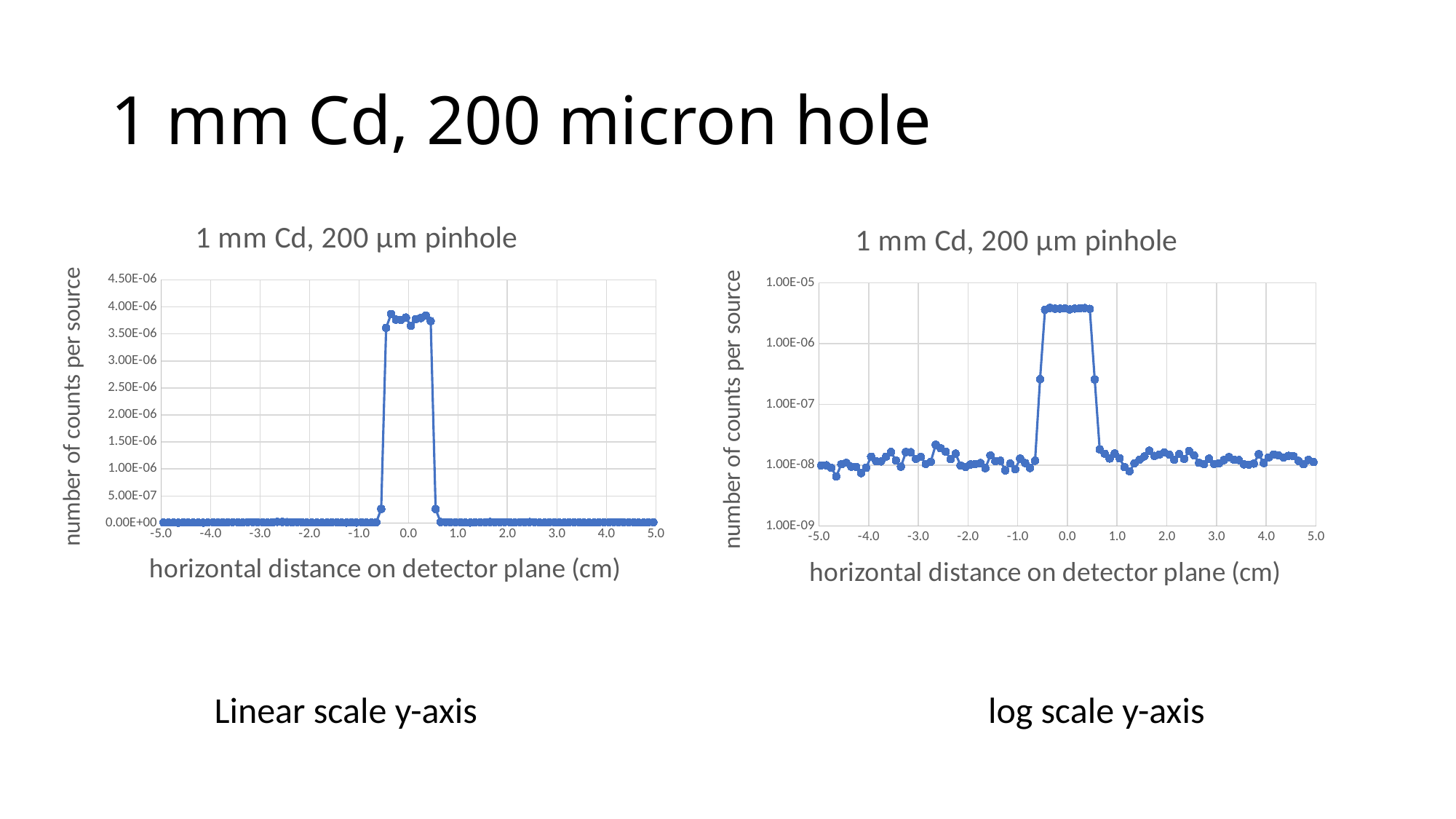
In the left chart (linear scale y-axis), is the value at a horizontal distance of 0.0 cm greater or less than 3.00E-06? greater In the left chart (linear scale y-axis), is the value at a horizontal distance of 3.0 cm greater or less than 5.00E-07? less In the right chart (log scale y-axis), is the value at a horizontal distance of 0.0 cm greater or less than 1.00E-06? greater What is the x-axis label of the left chart (linear scale y-axis)? horizontal distance on detector plane (cm) In the right chart (log scale y-axis), do the values rise or fall as the horizontal distance goes from 0.0 cm to 1.0 cm? fall What is the title of the right chart (log scale y-axis)? 1 mm Cd, 200 µm pinhole In the left chart (linear scale y-axis), is the value at a horizontal distance of 0.0 cm larger or smaller than the value at 2.0 cm? larger What kind of chart is the left chart (linear scale y-axis)? line chart In the left chart (linear scale y-axis), do the values rise or fall as the horizontal distance goes from -1.0 cm to 0.0 cm? rise